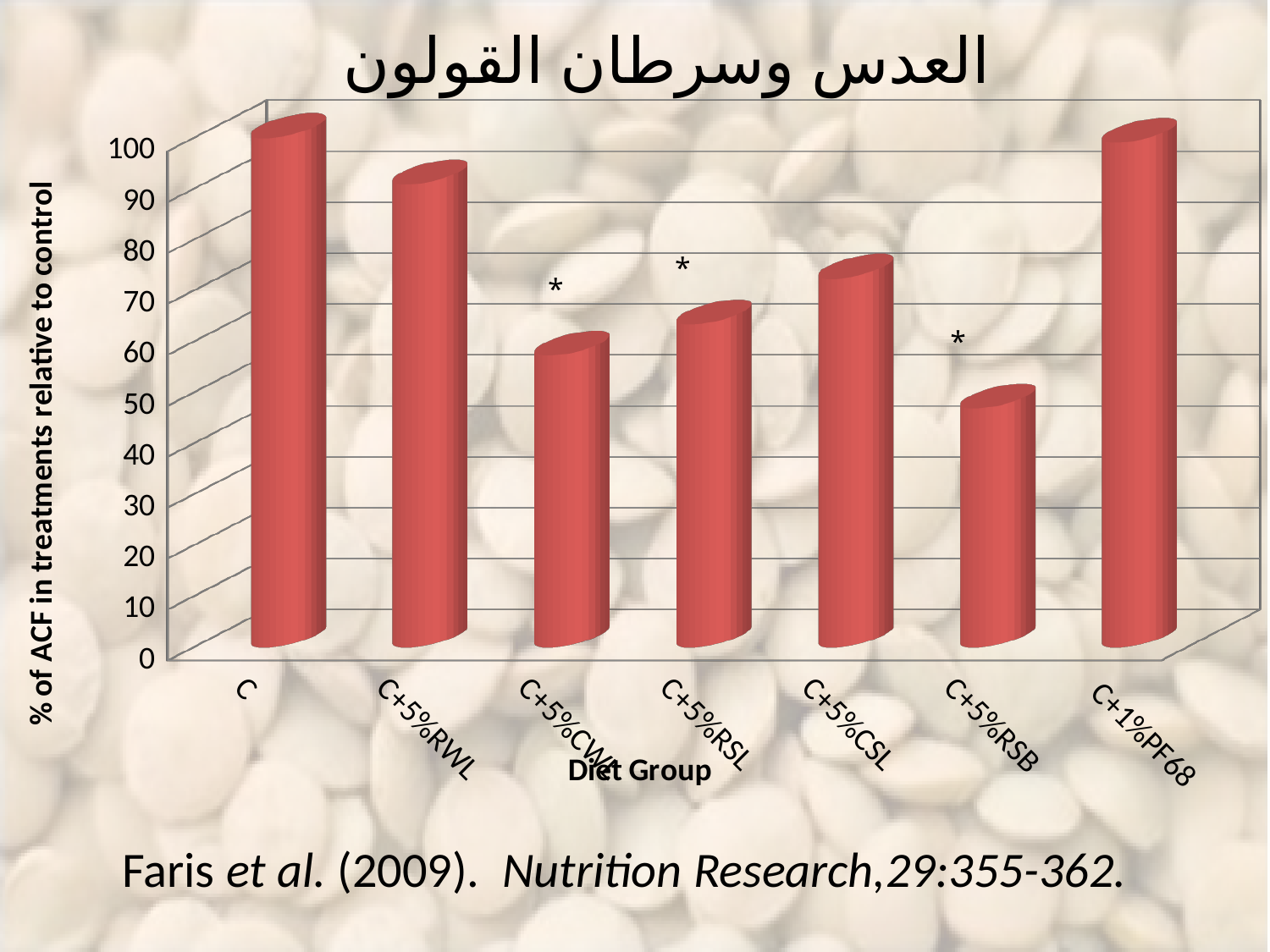
What is the label of the horizontal axis? Diet Group How many diet groups are plotted on the x axis? 7 What is the label of the vertical axis? % of ACF in treatments relative to control Is the value for C+5%CWL greater or less than 70? less Which diet group has the lowest % of ACF relative to control? C+5%RSB Which has a higher value, C+5%CSL or C+5%RSB? C+5%CSL Which has a higher value, C+5%RWL or C+5%CWL? C+5%RWL Is the value for C+5%RWL greater or less than 80? greater Is the value for C+5%CSL greater or less than 60? greater What kind of chart is shown on the slide? bar chart